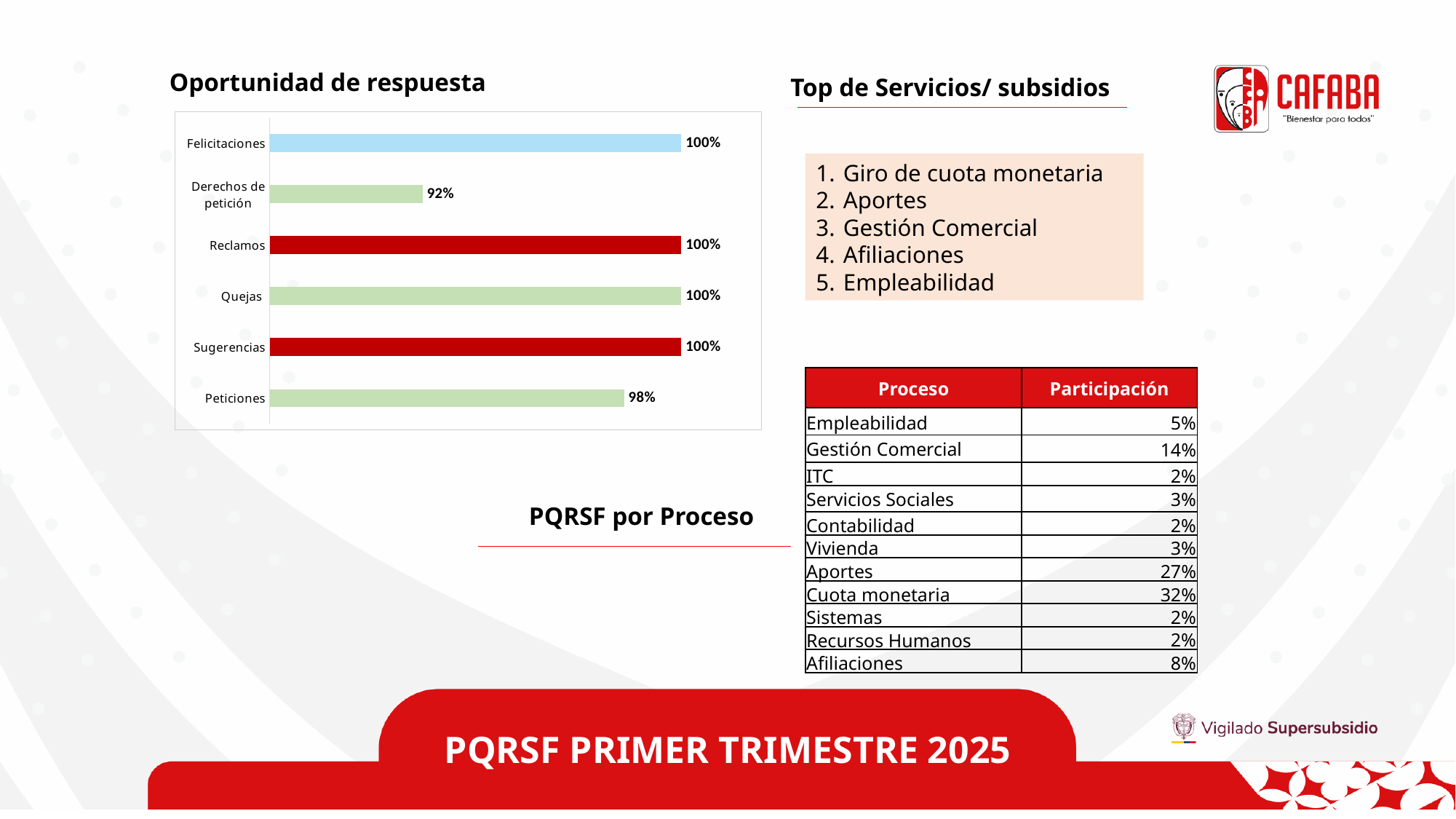
In the 'Oportunidad de respuesta' chart, what is the value for Derechos de petición? 92% What kind of chart is 'Oportunidad de respuesta'? Bar chart How many categories are shown in the 'Oportunidad de respuesta' chart? 6 In the 'Oportunidad de respuesta' chart, what is the value for Peticiones? 98% In the 'Oportunidad de respuesta' chart, which is larger, the value for Sugerencias or the value for Derechos de petición? Sugerencias In the 'Oportunidad de respuesta' chart, what is the difference between the values for Peticiones and Derechos de petición? 6% In the 'Oportunidad de respuesta' chart, which is larger, the value for Peticiones or the value for Derechos de petición? Peticiones In the 'Oportunidad de respuesta' chart, how many categories have a value of 100%? 4 In the 'Oportunidad de respuesta' chart, what is the value for Quejas? 100% In the 'Oportunidad de respuesta' chart, which category has the lowest value? Derechos de petición In the 'Oportunidad de respuesta' chart, what is the difference between the values for Reclamos and Peticiones? 2% In the 'Oportunidad de respuesta' chart, what is the value for Felicitaciones? 100%